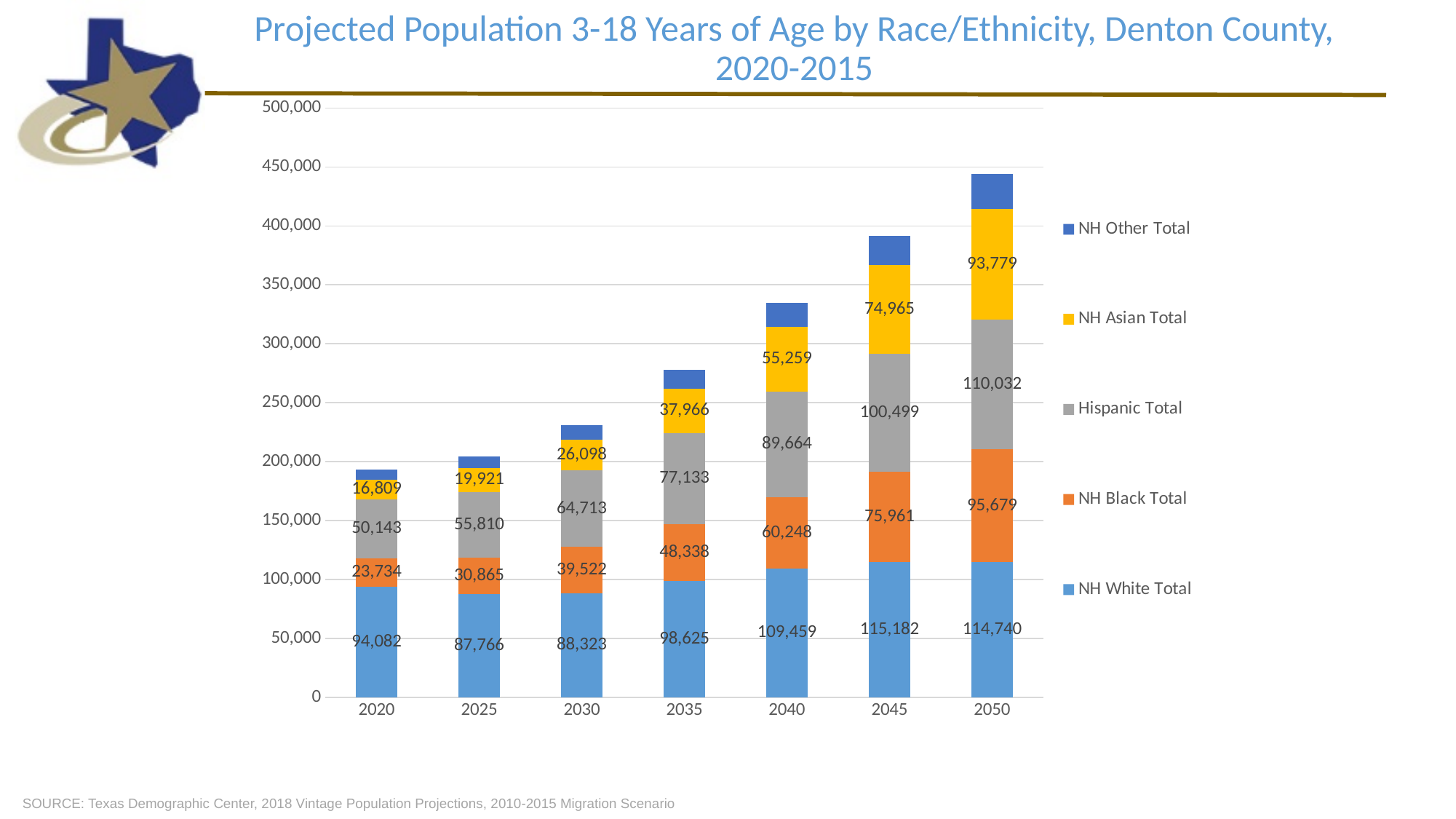
How much larger is the Hispanic Total in 2050 than in 2045? 9,533 What is the difference between the NH White Total in 2045 and in 2020? 21,100 In which year is the NH Black Total highest? 2050 In which year is the NH White Total lowest? 2025 What is the NH Asian Total value for 2050? 93,779 What is the NH White Total value for 2040? 109,459 How many series does the legend list? 5 How many years are shown on the x axis? 7 What is the Hispanic Total value for 2020? 50,143 What kind of chart is shown on the slide? Stacked bar chart In 2045, which is larger: the NH Asian Total or the NH Black Total? NH Black Total Is the total height of the stacked bar for 2050 greater or less than 400,000? greater